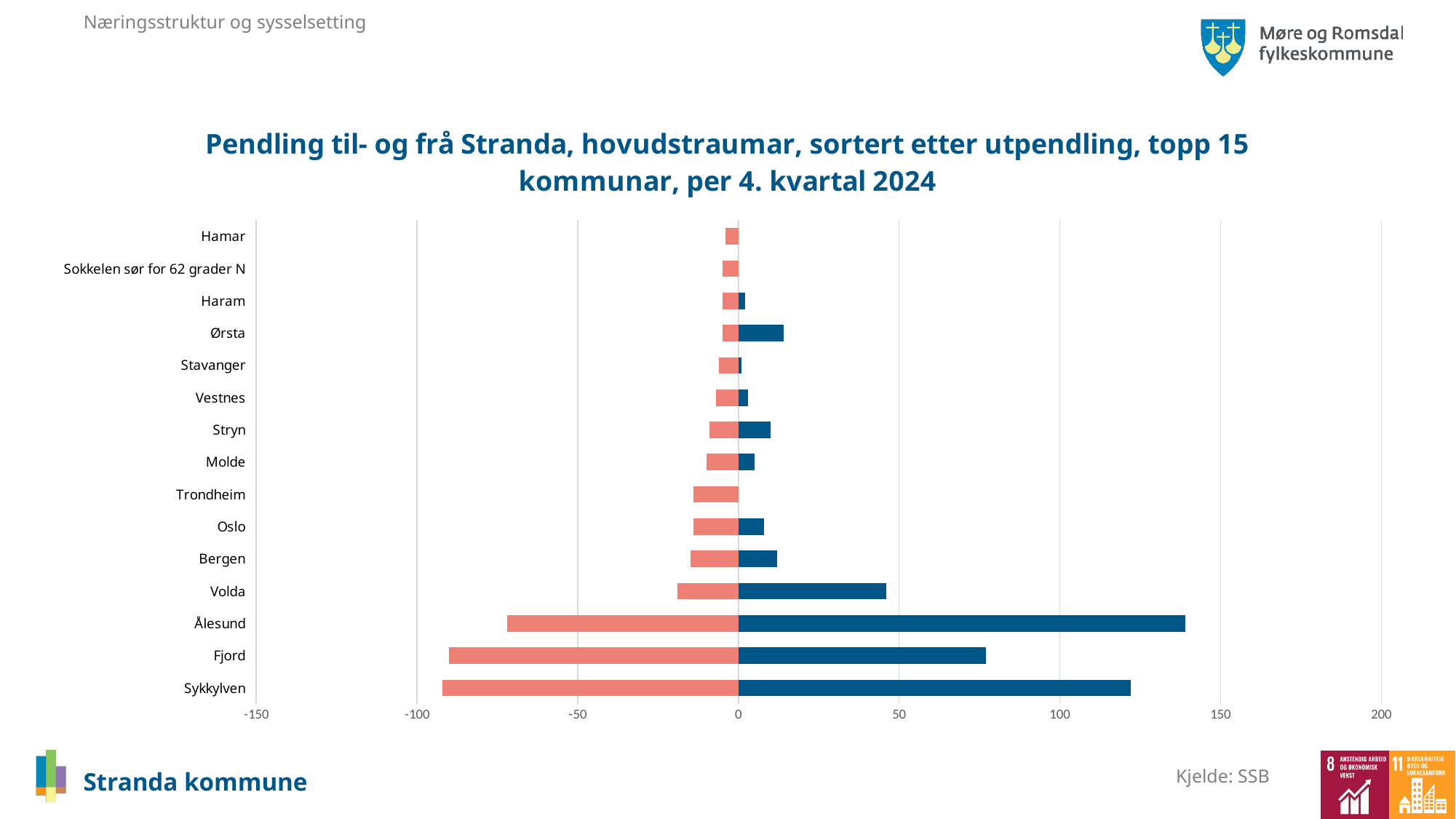
Is the dark blue bar for Volda greater or less than 50? less Which has the larger dark blue bar, Volda or Bergen? Volda How many municipalities (categories) are listed on the chart? 15 Which municipality has the longest dark blue bar (largest positive value)? Ålesund Is the dark blue bar for Sykkylven greater or less than 100? greater Is the dark blue bar for Ålesund greater or less than 100? greater What is the title of the chart? Pendling til- og frå Stranda, hovudstraumar, sortert etter utpendling, topp 15 kommunar, per 4. kvartal 2024 Which has the larger dark blue bar, Ålesund or Fjord? Ålesund What source is cited for the chart data? SSB What kind of chart is shown on the slide? bar chart